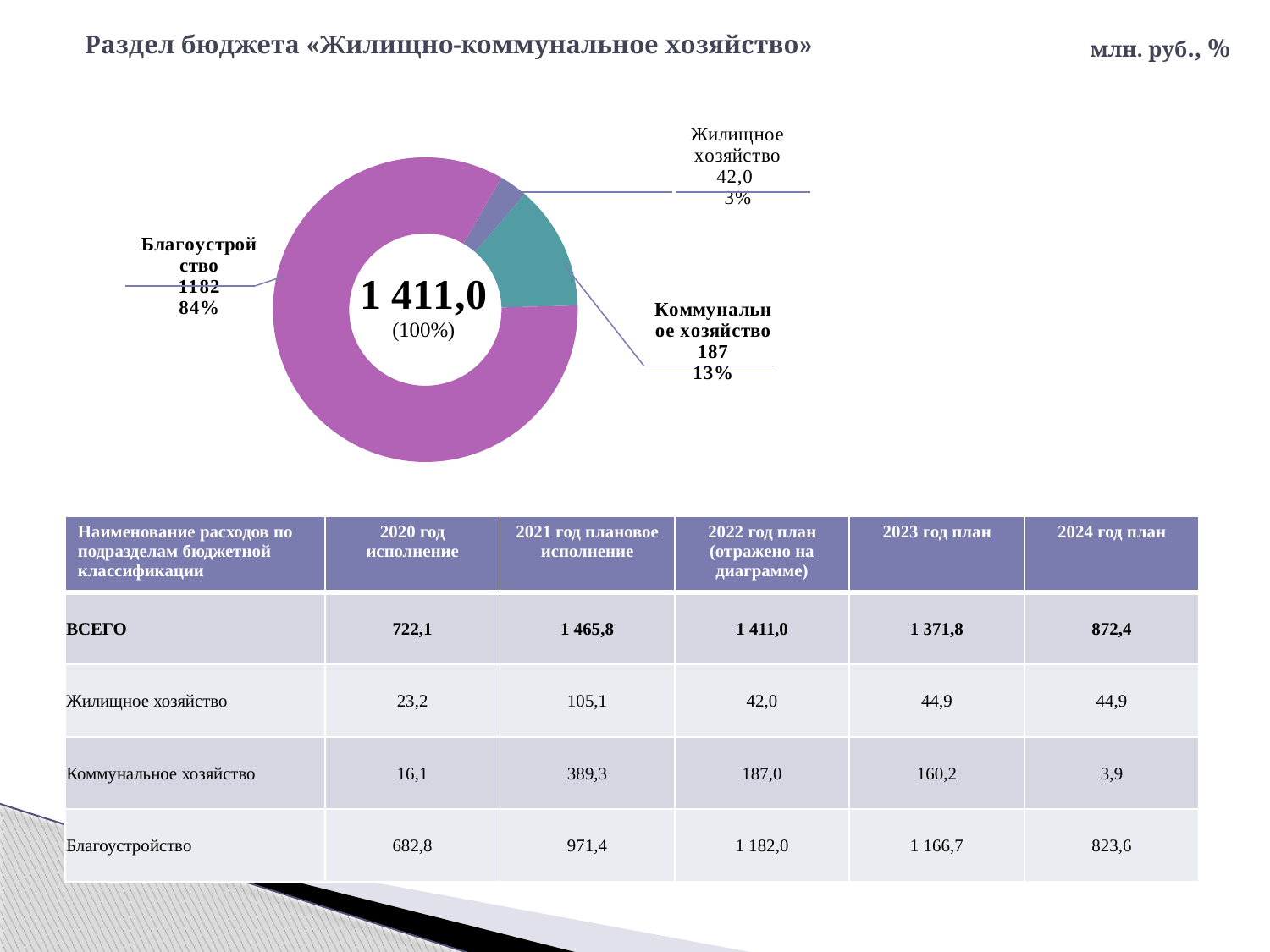
Which is larger on the doughnut chart: Коммунальное хозяйство or Жилищное хозяйство? Коммунальное хозяйство What value is shown for Жилищное хозяйство on the doughnut chart? 42,0 What value is shown for Благоустройство on the doughnut chart? 1182 How many categories are shown on the doughnut chart? 3 What share of the doughnut chart does Коммунальное хозяйство represent? 13% Which category has the smallest slice of the doughnut chart? Жилищное хозяйство What share of the doughnut chart does Благоустройство represent? 84% What share of the doughnut chart does Жилищное хозяйство represent? 3% What total value is shown in the centre of the doughnut chart? 1 411,0 Which category has the largest slice of the doughnut chart? Благоустройство What is the difference between the values for Благоустройство and Коммунальное хозяйство on the doughnut chart? 995 What value is shown for Коммунальное хозяйство on the doughnut chart? 187